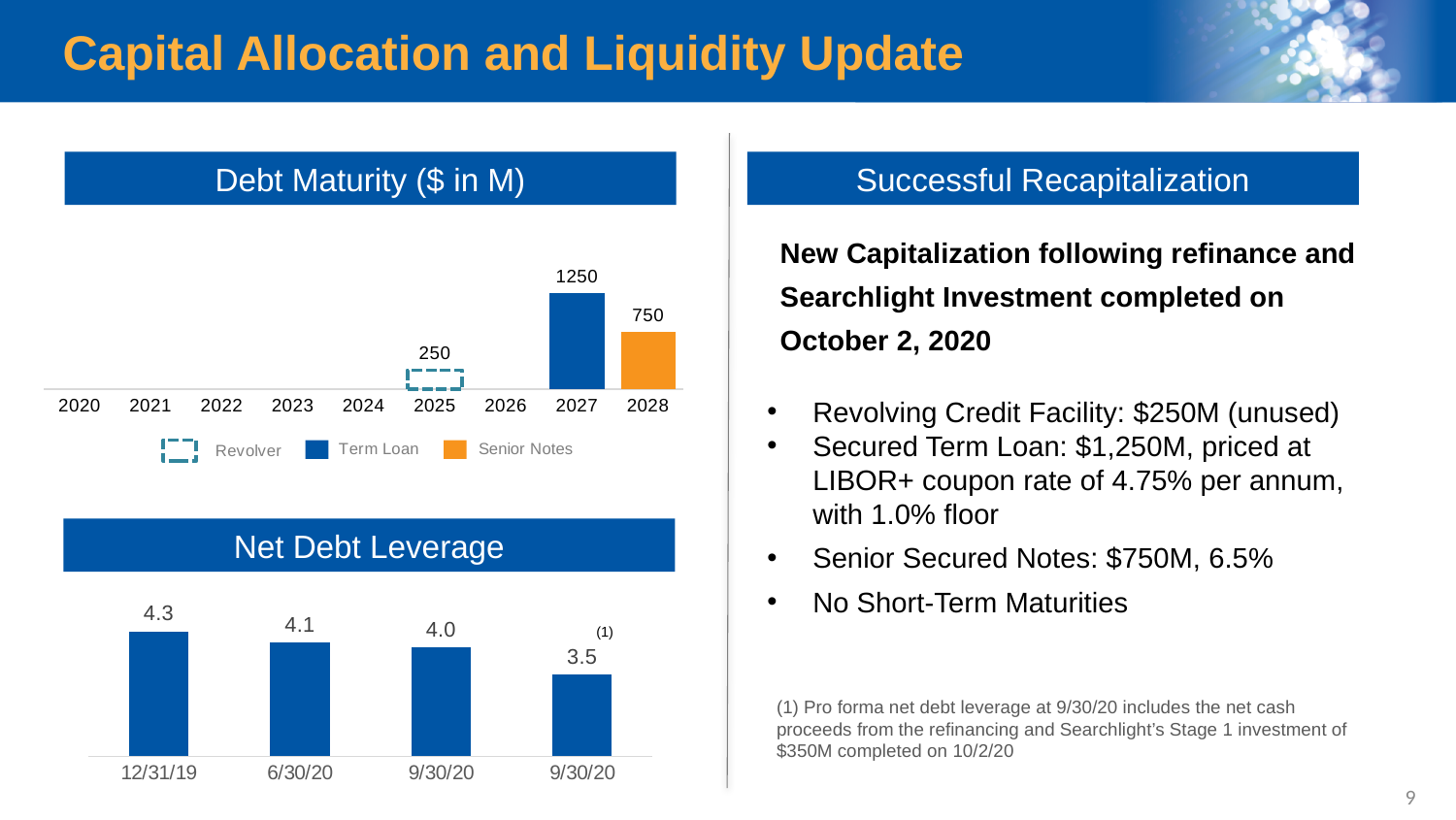
In the Net Debt Leverage chart, what is the value for 6/30/20? 4.1 What kind of chart is the Net Debt Leverage chart? bar chart How many years are shown on the x axis of the Debt Maturity chart? 9 In the Debt Maturity chart, what is the difference between the 2027 Term Loan and the 2028 Senior Notes values? 500 In the Net Debt Leverage chart, do the values rise or fall from left to right? fall In the Debt Maturity chart, what is the Term Loan value shown for 2027? 1250 How many series does the legend of the Debt Maturity chart list? 3 In the Debt Maturity chart, what is the Senior Notes value shown for 2028? 750 In the Debt Maturity chart, what is the Revolver value shown for 2025? 250 In the Net Debt Leverage chart, what is the value of the last bar, the pro forma 9/30/20 marked (1)? 3.5 In the Net Debt Leverage chart, what is the value for 12/31/19? 4.3 In the Debt Maturity chart, which year has the highest debt maturity? 2027